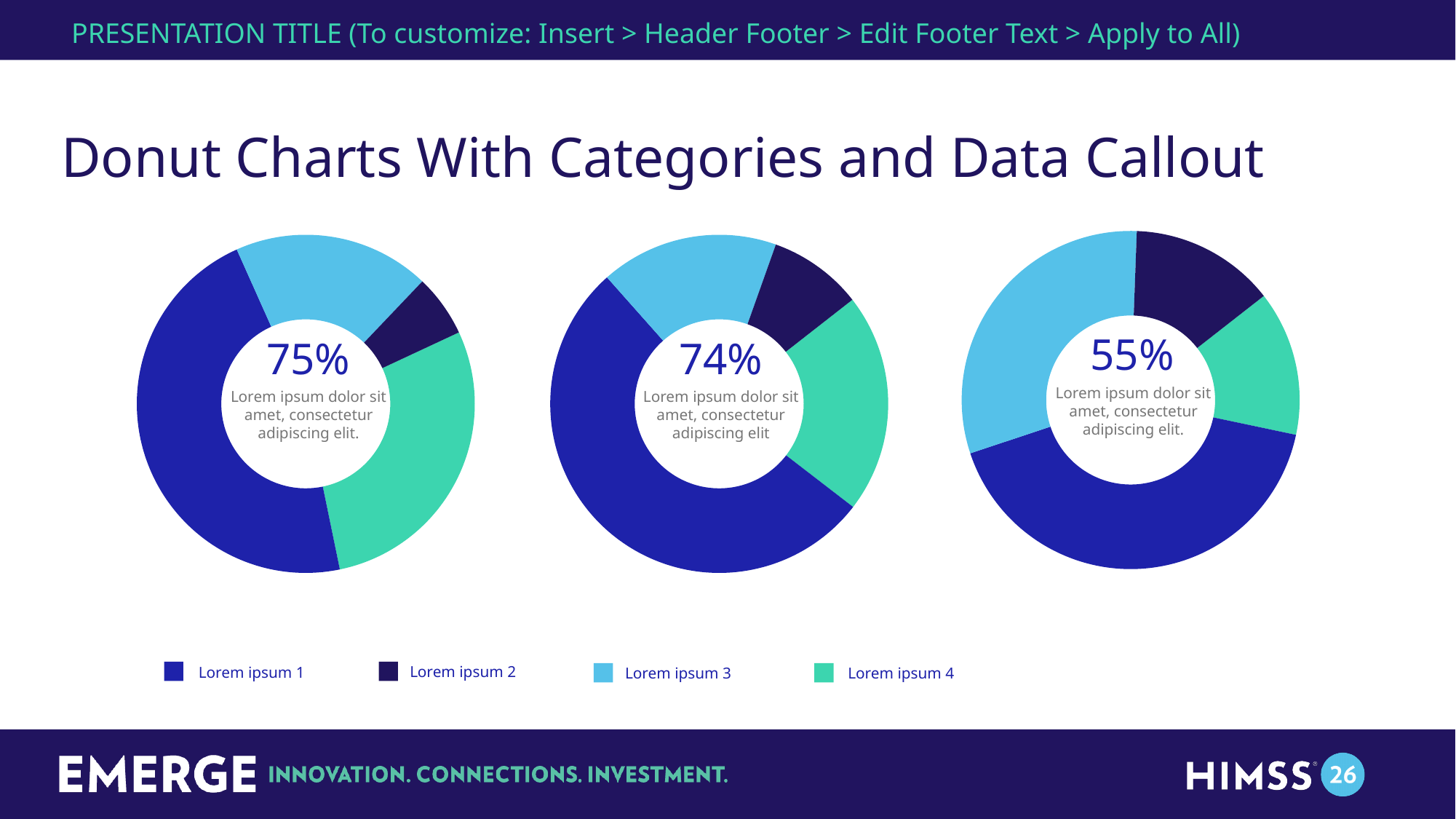
How many donut charts are on the slide? 3 In the middle donut chart, which category has the largest slice? Lorem ipsum 1 In the left donut chart, which category has the smallest slice? Lorem ipsum 2 In the middle donut chart, which slice is larger, Lorem ipsum 2 or Lorem ipsum 3? Lorem ipsum 3 In the right donut chart, which slice is larger, Lorem ipsum 1 or Lorem ipsum 3? Lorem ipsum 1 In the middle donut chart, what percentage is printed in the centre callout? 74% In the right donut chart, what percentage is printed in the centre callout? 55% What is the title of the slide? Donut Charts With Categories and Data Callout How many categories does the legend list? 4 In the left donut chart, which category has the largest slice? Lorem ipsum 1 What kind of chart is shown on the slide? donut chart In the left donut chart, what percentage is printed in the centre callout? 75%